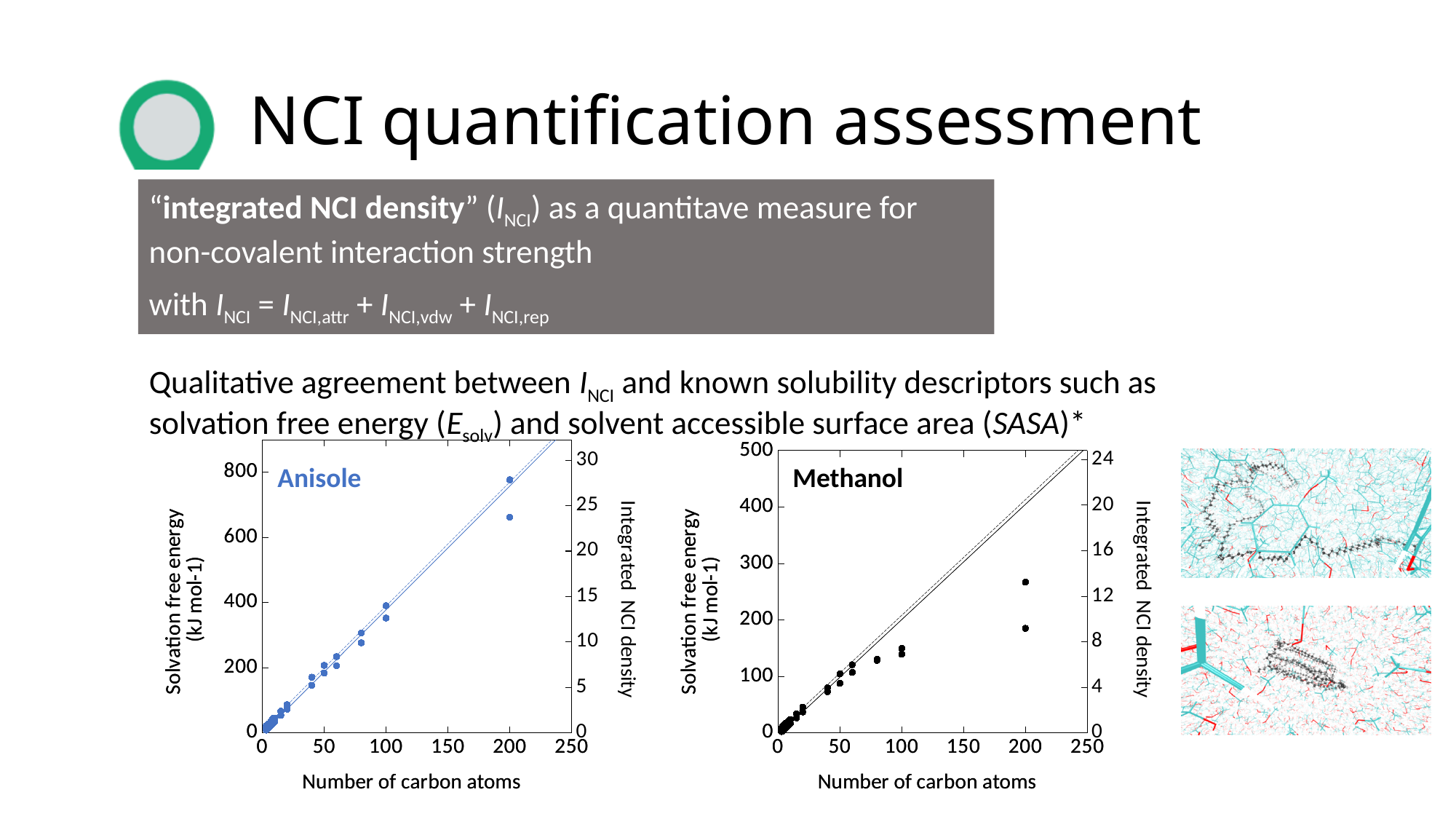
In the Methanol chart, is the solvation free energy at 200 carbon atoms greater or less than 300 kJ mol-1? less In the Anisole chart, is the solvation free energy at 200 carbon atoms greater or less than 600 kJ mol-1? greater What kind of chart is the Anisole chart? scatter chart In the Methanol chart, do the plotted values rise or fall as the number of carbon atoms increases? rise What kind of chart is the Methanol chart? scatter chart How many charts are shown on the slide? 2 In the Anisole chart, is the solvation free energy at 100 carbon atoms greater or less than 300 kJ mol-1? greater What is the label of the right-hand y-axis of the Anisole chart? Integrated NCI density What is the x-axis label of the Methanol chart? Number of carbon atoms In the Anisole chart, do the plotted values rise or fall as the number of carbon atoms increases? rise